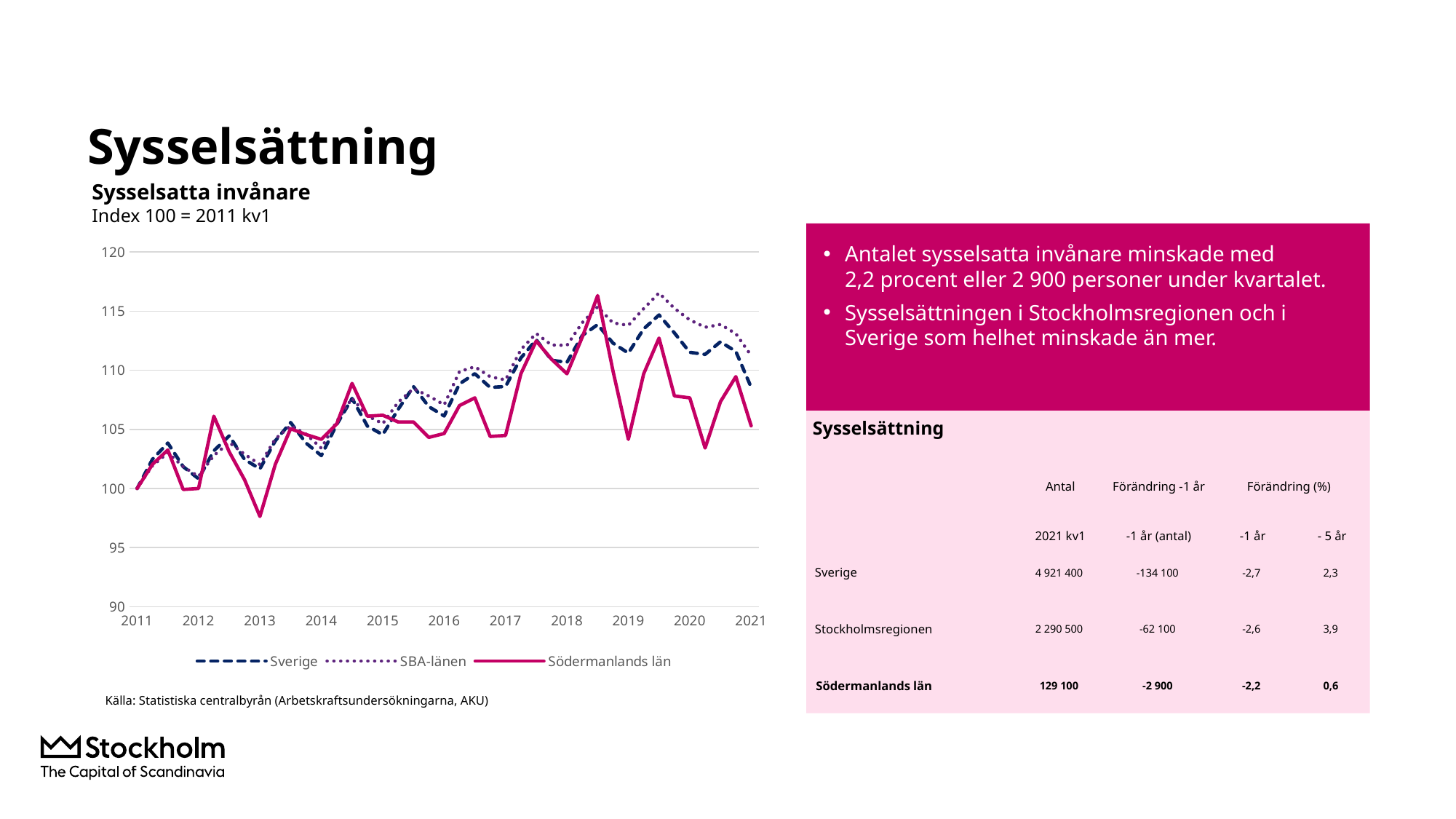
Which series are listed in the chart legend? Sverige, SBA-länen, Södermanlands län Is the value for Södermanlands län at its lowest point in 2013 greater or less than 100? less How many series does the chart legend list? 3 Is the value for Sverige at the start of 2014 greater or less than 105? less At the end of the chart in 2021, which is higher: Sverige or Södermanlands län? Sverige What index value do all three series have at the start of the chart in 2011? 100 Does the Sverige series overall rise or fall from 2011 to 2021? rise Which series has the lowest value in 2013? Södermanlands län What is the title of the chart? Sysselsatta invånare What kind of chart is shown on the slide? line chart Is the value for Sverige at the end of the chart in 2021 greater or less than 105? greater